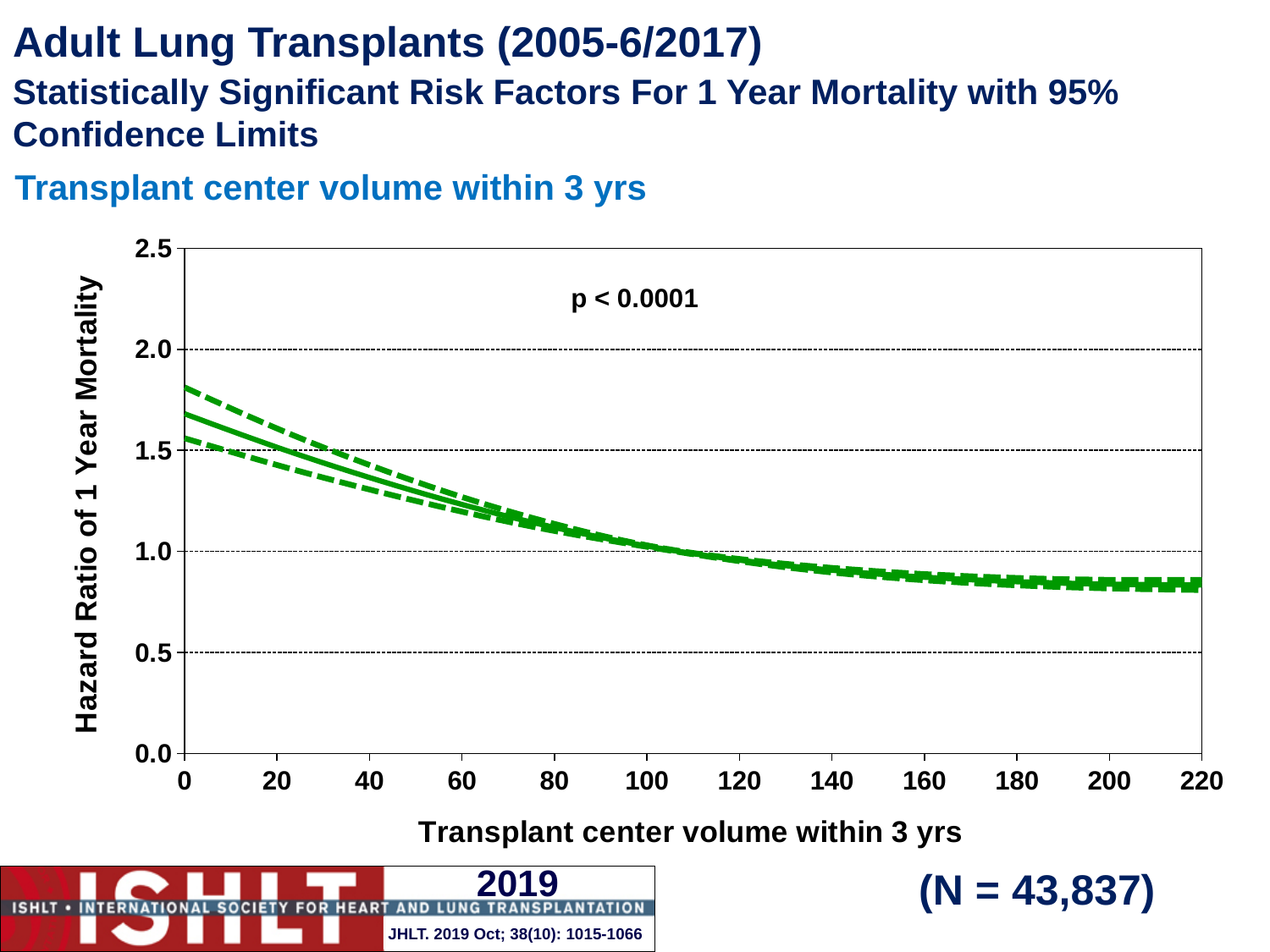
Is the hazard ratio (solid line) at a transplant center volume of 200 greater or less than 0.5? greater How many lines are plotted on the chart? 3 Is the upper 95% confidence limit (upper dashed line) at a transplant center volume of 0 greater or less than 2.0? less What kind of chart is shown on the slide? line chart Is the hazard ratio (solid line) at a transplant center volume of 60 greater or less than 1.5? less What is the label of the y axis? Hazard Ratio of 1 Year Mortality Does the hazard ratio rise or fall as transplant center volume within 3 yrs increases? fall What p-value is printed on the chart? p < 0.0001